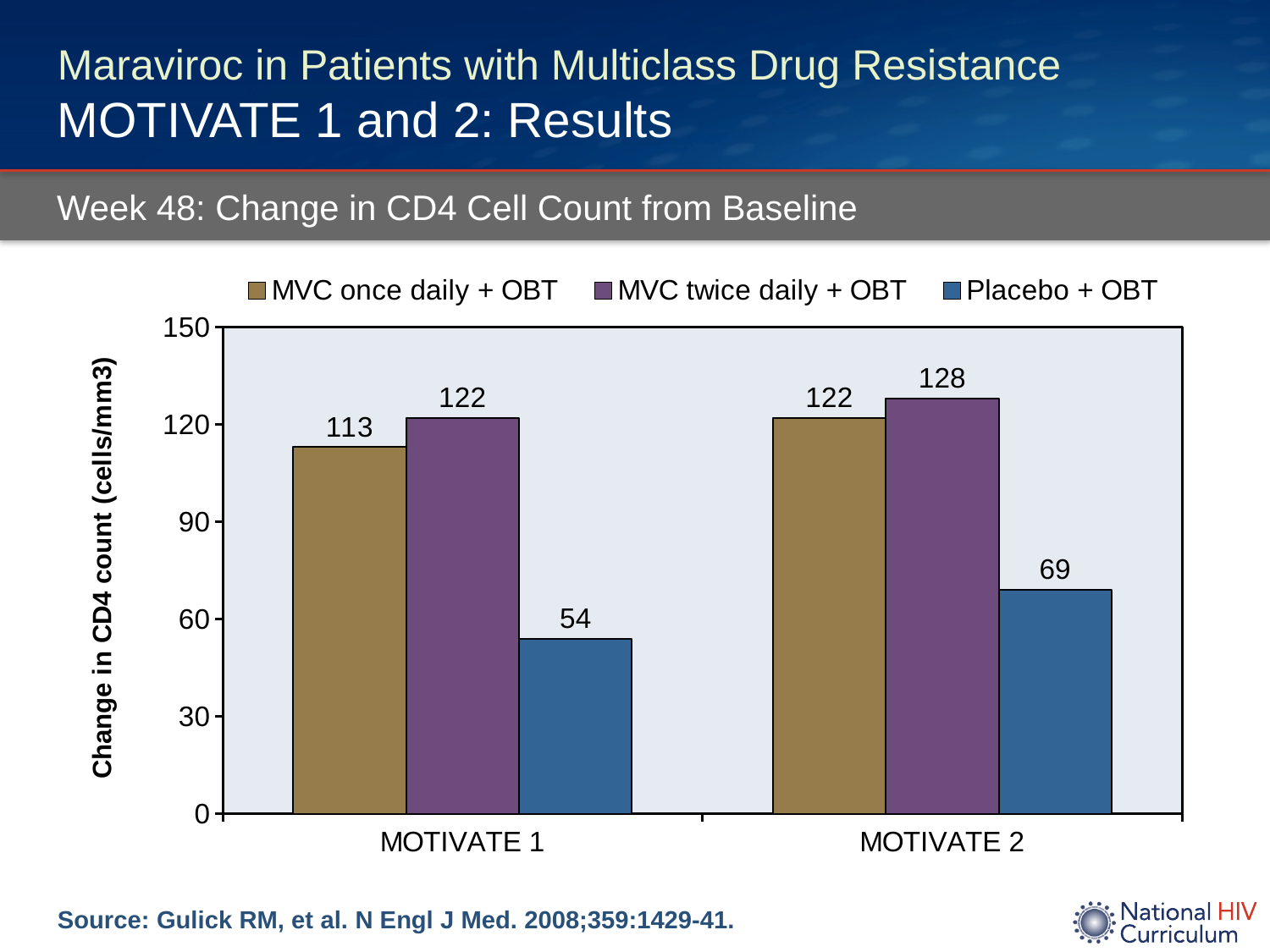
Which treatment arm has the lowest change in CD4 count in MOTIVATE 1? Placebo + OBT What is the difference between the MVC twice daily + OBT and Placebo + OBT values in MOTIVATE 1? 68 How many series does the legend list? 3 Is the value for Placebo + OBT in MOTIVATE 1 greater or less than 60? less How many study groups are shown on the x axis? 2 What is the change in CD4 count for Placebo + OBT in MOTIVATE 2? 69 What is the change in CD4 count for MVC twice daily + OBT in MOTIVATE 2? 128 What kind of chart is shown on the slide? Bar chart What is the change in CD4 count for MVC once daily + OBT in MOTIVATE 1? 113 Which is larger: the Placebo + OBT value in MOTIVATE 1 or in MOTIVATE 2? MOTIVATE 2 Which treatment arm has the highest change in CD4 count in MOTIVATE 2? MVC twice daily + OBT What is the difference between the MVC once daily + OBT values in MOTIVATE 2 and MOTIVATE 1? 9